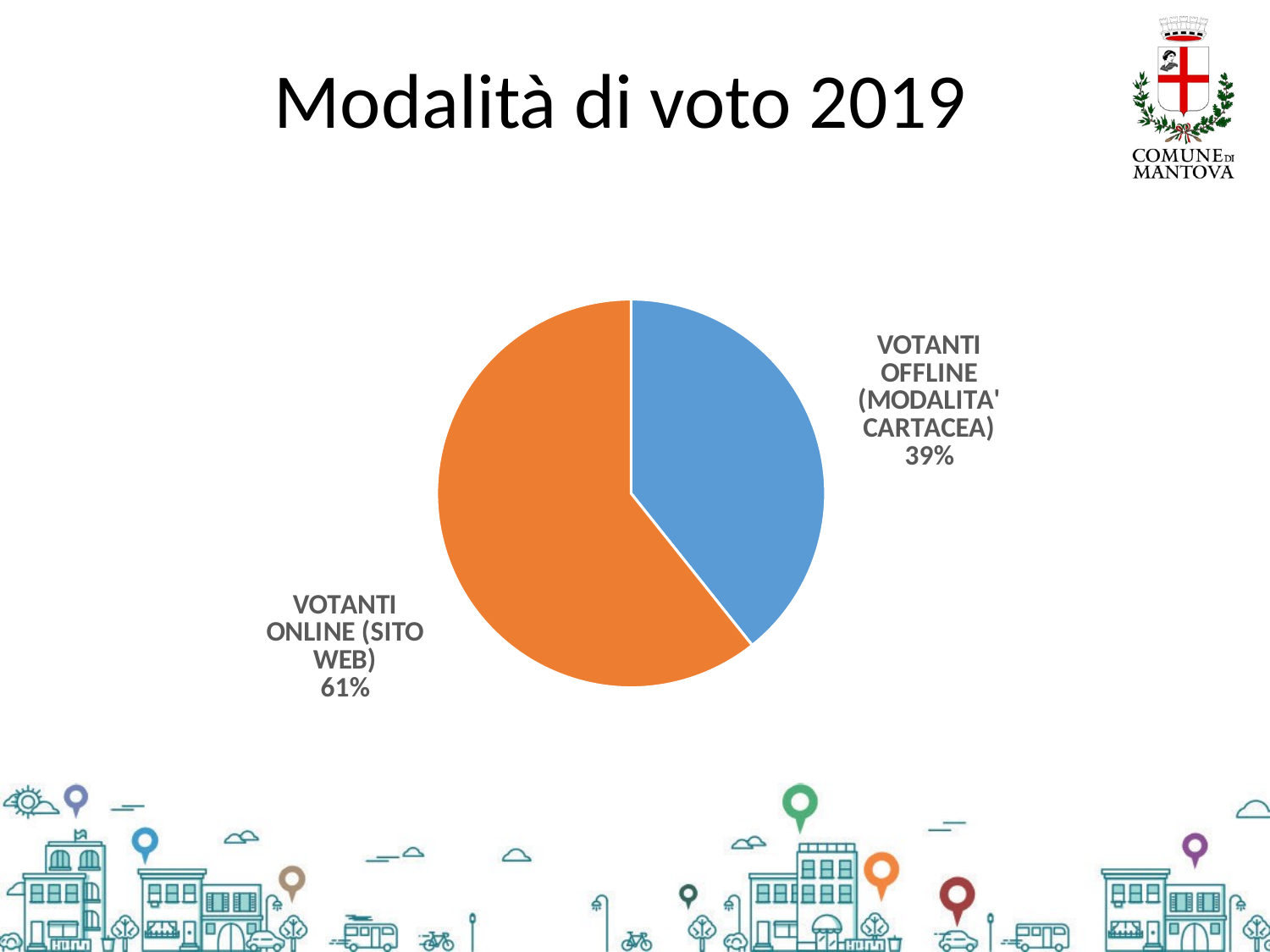
What share of the pie is labelled VOTANTI ONLINE (SITO WEB)? 61% What is the total of the two percentages shown on the pie chart? 100% How many slices does the pie chart have? 2 What colour is the slice for VOTANTI OFFLINE (MODALITA' CARTACEA)? blue By how many percentage points does the online share exceed the offline share? 22 Which slice of the pie is the largest? VOTANTI ONLINE (SITO WEB) Which slice of the pie is the smallest? VOTANTI OFFLINE (MODALITA' CARTACEA) What share of the pie is labelled VOTANTI OFFLINE (MODALITA' CARTACEA)? 39% Which is larger, the share of VOTANTI ONLINE (SITO WEB) or VOTANTI OFFLINE (MODALITA' CARTACEA)? VOTANTI ONLINE (SITO WEB) What kind of chart is shown on the slide? pie chart What is the title of the slide containing the chart? Modalità di voto 2019